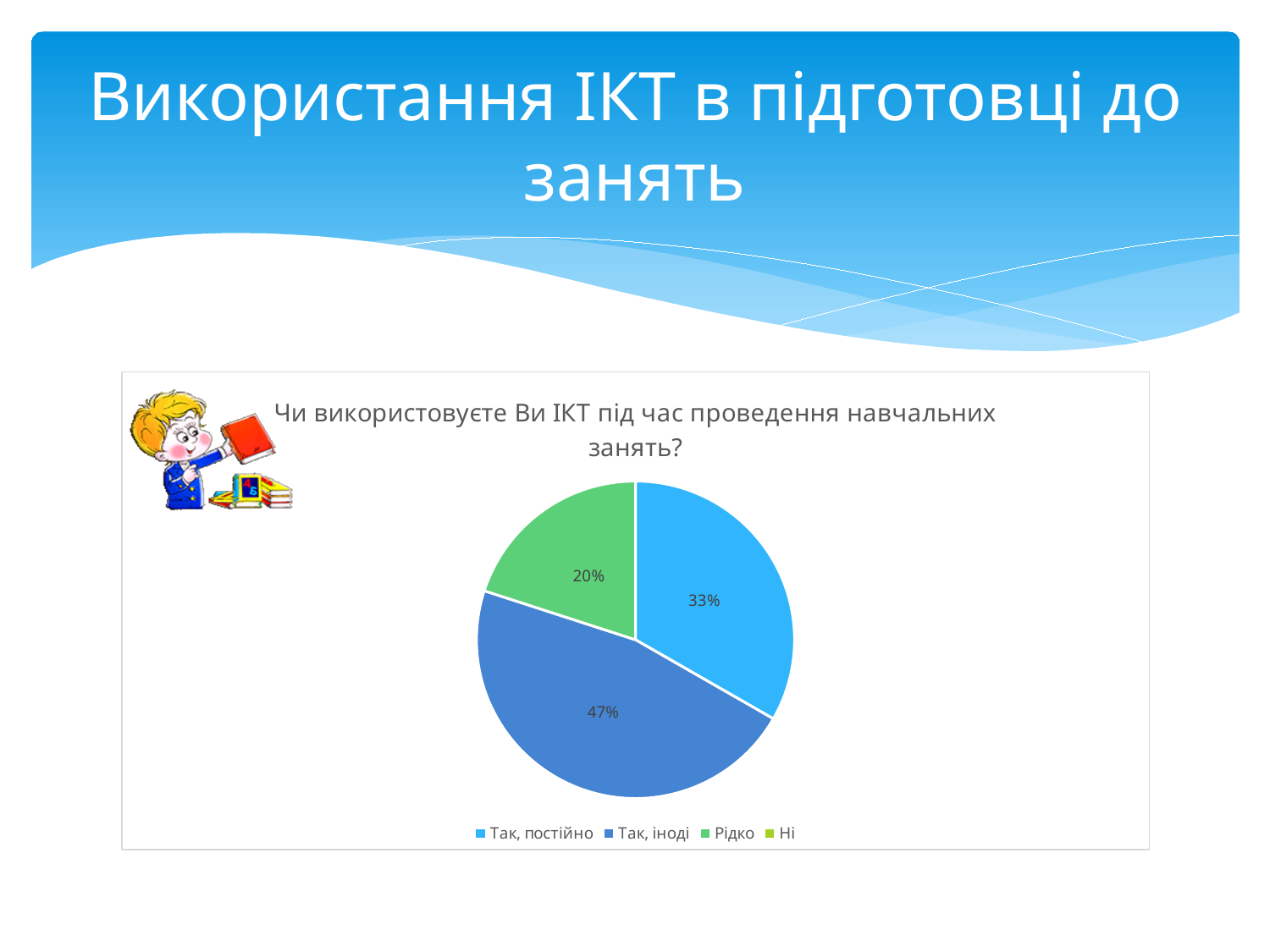
What is the difference in percentage points between "Так, іноді" and "Так, постійно"? 14 What percentage of the pie is labelled for "Так, іноді"? 47% Which of the labelled slices is the smallest? Рідко What kind of chart is shown on the slide? pie chart How many slices with percentage labels are visible in the pie? 3 Which is larger, the slice for "Так, постійно" or the slice for "Рідко"? Так, постійно What share of the pie does "Так, іноді" take? 47% What percentage of the pie is labelled for "Рідко"? 20% What is the title of the chart? Чи використовуєте Ви ІКТ під час проведення навчальних занять? Which category has the largest slice of the pie? Так, іноді How many entries does the legend list? 4 What percentage of the pie is labelled for "Так, постійно"? 33%